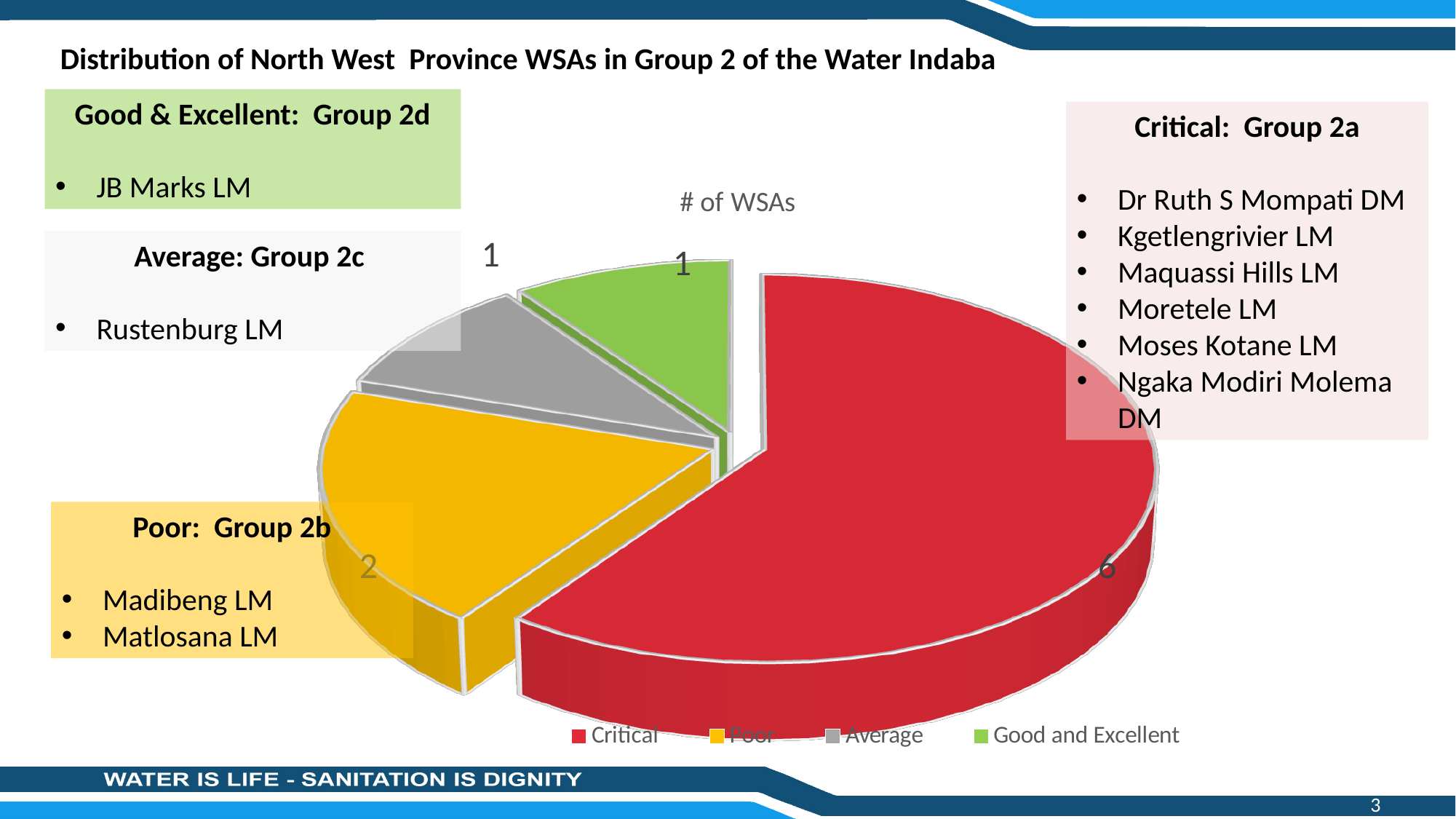
How many categories does the legend of the chart list? 4 Which is larger, the Poor slice or the Average slice? Poor What is the difference between the Critical value and the Poor value? 4 Which colour represents the Good and Excellent category in the chart? green What type of chart is shown on the slide? pie chart What is the title of the chart? # of WSAs Which category has the largest slice of the pie? Critical What share of the pie does the Critical slice represent? 60% What is the total of all the slices in the pie? 10 What is the value for the Critical slice? 6 What is the value for the Average slice? 1 What is the value for the Poor slice? 2